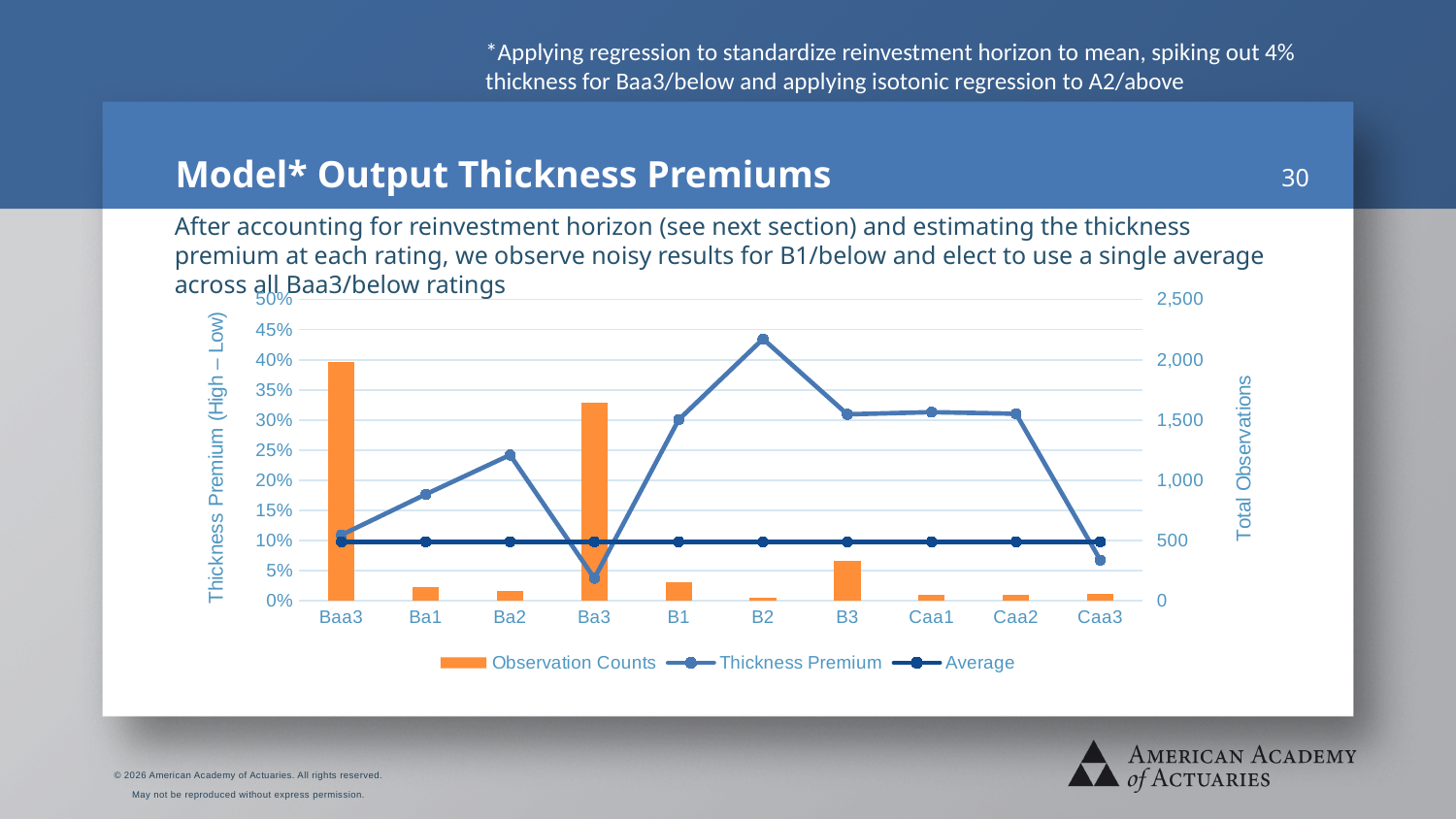
Does the Thickness Premium rise or fall from B2 to Caa3? It falls Which rating has the lowest Thickness Premium? Ba3 Is the Thickness Premium for B2 greater or less than 40%? greater How many rating categories are shown on the x axis of the chart? 10 How many series does the chart legend list? 3 Is the Observation Counts value for Baa3 greater or less than 1,500? greater What kind of chart is shown on the slide? A combination bar and line chart Which rating has the highest Thickness Premium? B2 Which has the larger Observation Counts, Baa3 or Ba3? Baa3 Which rating has the highest Observation Counts bar? Baa3 Is the Thickness Premium for Ba3 greater or less than 5%? less What is the title of the chart's right-hand vertical axis? Total Observations